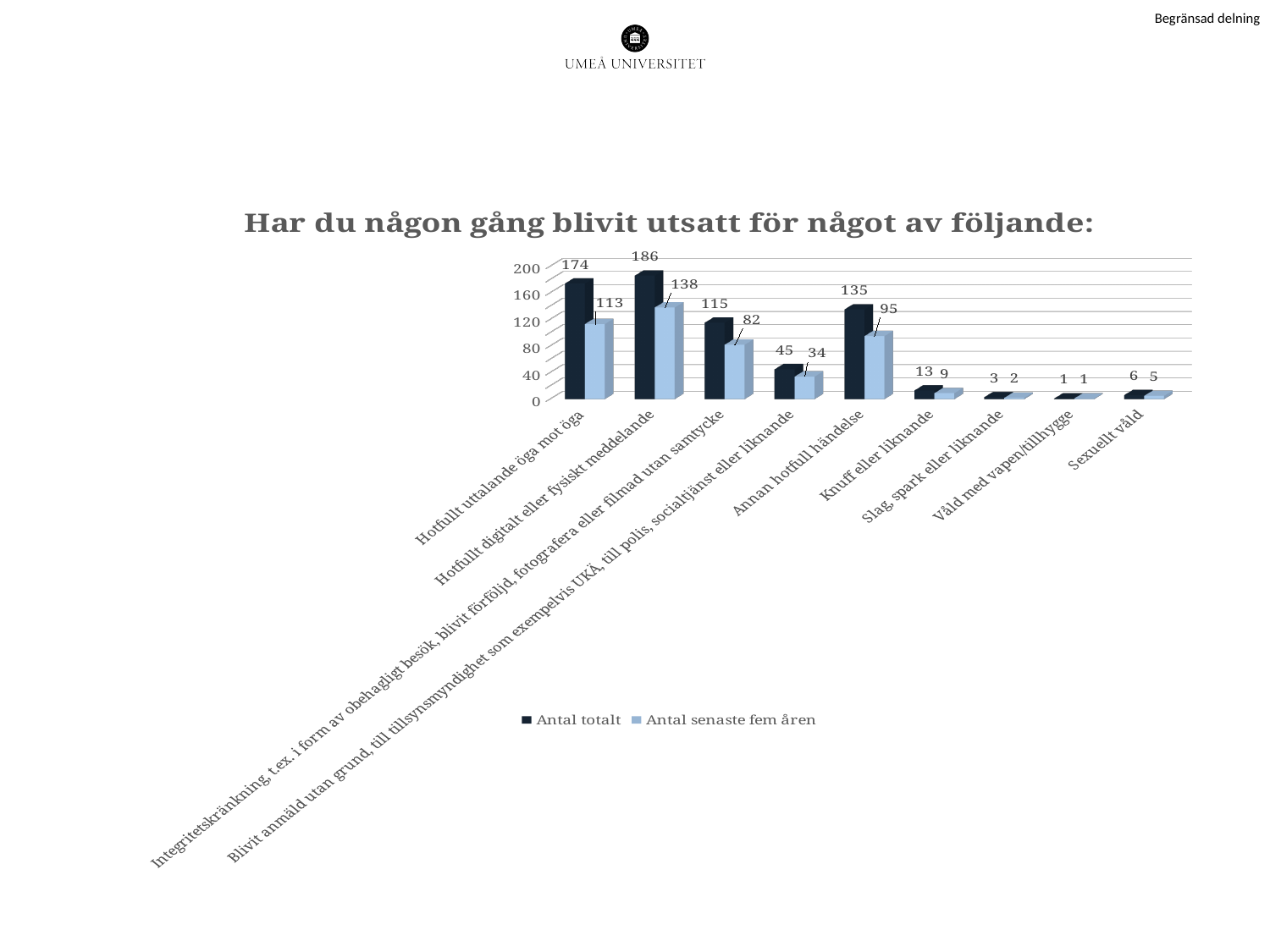
Is the value of "Antal senaste fem åren" for "Annan hotfull händelse" greater or less than 80? greater What is the difference between "Antal totalt" and "Antal senaste fem åren" for "Hotfullt uttalande öga mot öga"? 61 Which category has the highest value for "Antal totalt"? Hotfullt digitalt eller fysiskt meddelande What is the value of "Antal senaste fem åren" for "Hotfullt digitalt eller fysiskt meddelande"? 138 What kind of chart is shown on the slide? Bar chart Which is larger: "Antal totalt" for "Annan hotfull händelse" or "Antal totalt" for "Hotfullt uttalande öga mot öga"? Hotfullt uttalande öga mot öga What is the title of the chart? Har du någon gång blivit utsatt för något av följande: How many categories are shown on the x axis? 9 What is the value of "Antal totalt" for "Hotfullt uttalande öga mot öga"? 174 Which category has the lowest value for "Antal totalt"? Våld med vapen/tillhygge What is the value of "Antal totalt" for "Annan hotfull händelse"? 135 How many series does the legend list? 2